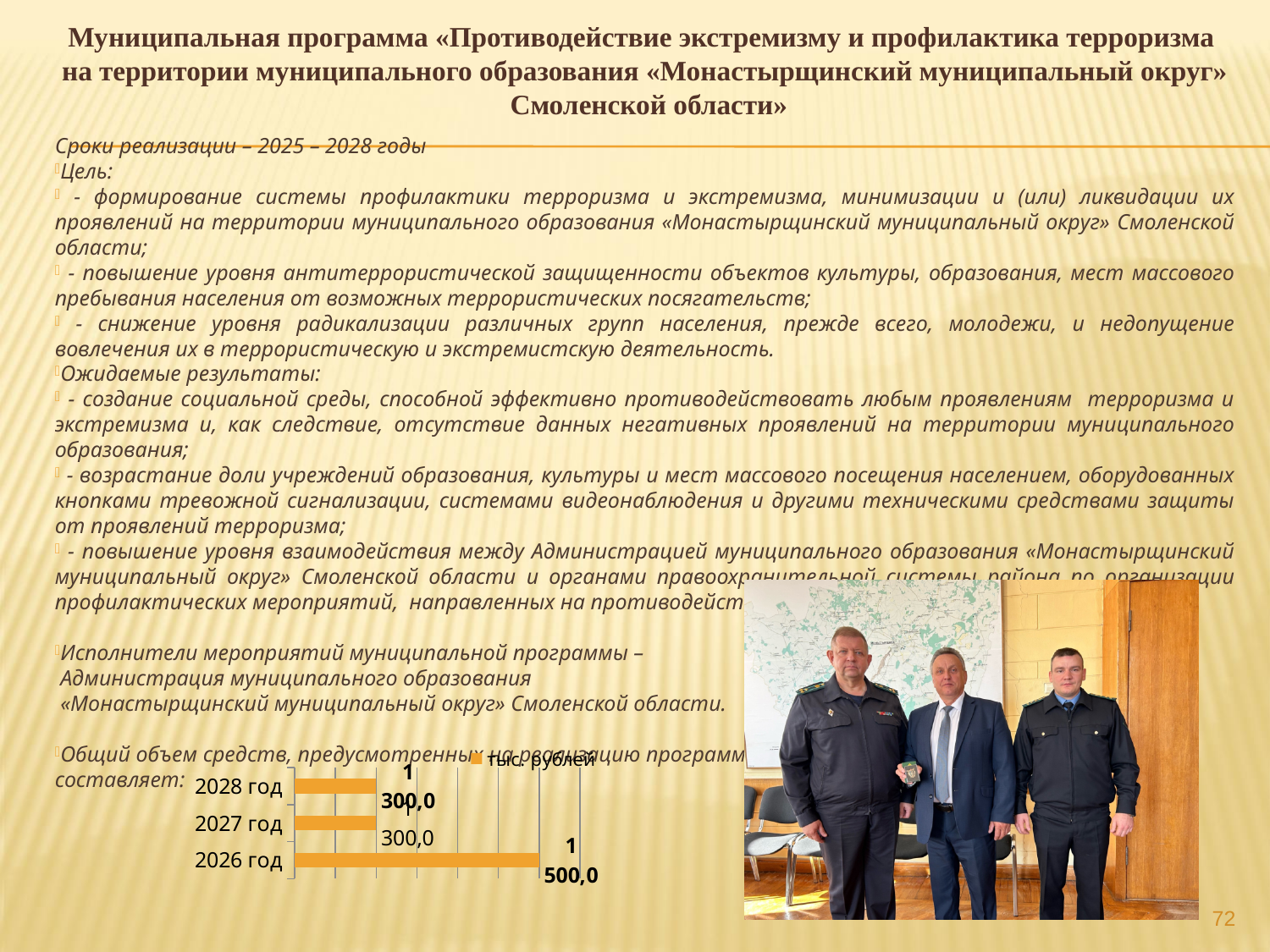
Which year has the highest value in the bar chart? 2026 год How many series does the chart legend list? 1 What is the difference between the values for 2026 год and 2028 год? 200,0 What is the legend entry of the chart? тыс. рублей Which is larger, the value for 2026 год or the value for 2028 год? 2026 год What is the value for 2028 год in the bar chart? 1 300,0 What kind of chart is shown on the slide? bar chart How many categories (years) are shown in the bar chart? 3 Which year is listed at the top of the bar chart? 2028 год What is the value for 2026 год in the bar chart? 1 500,0